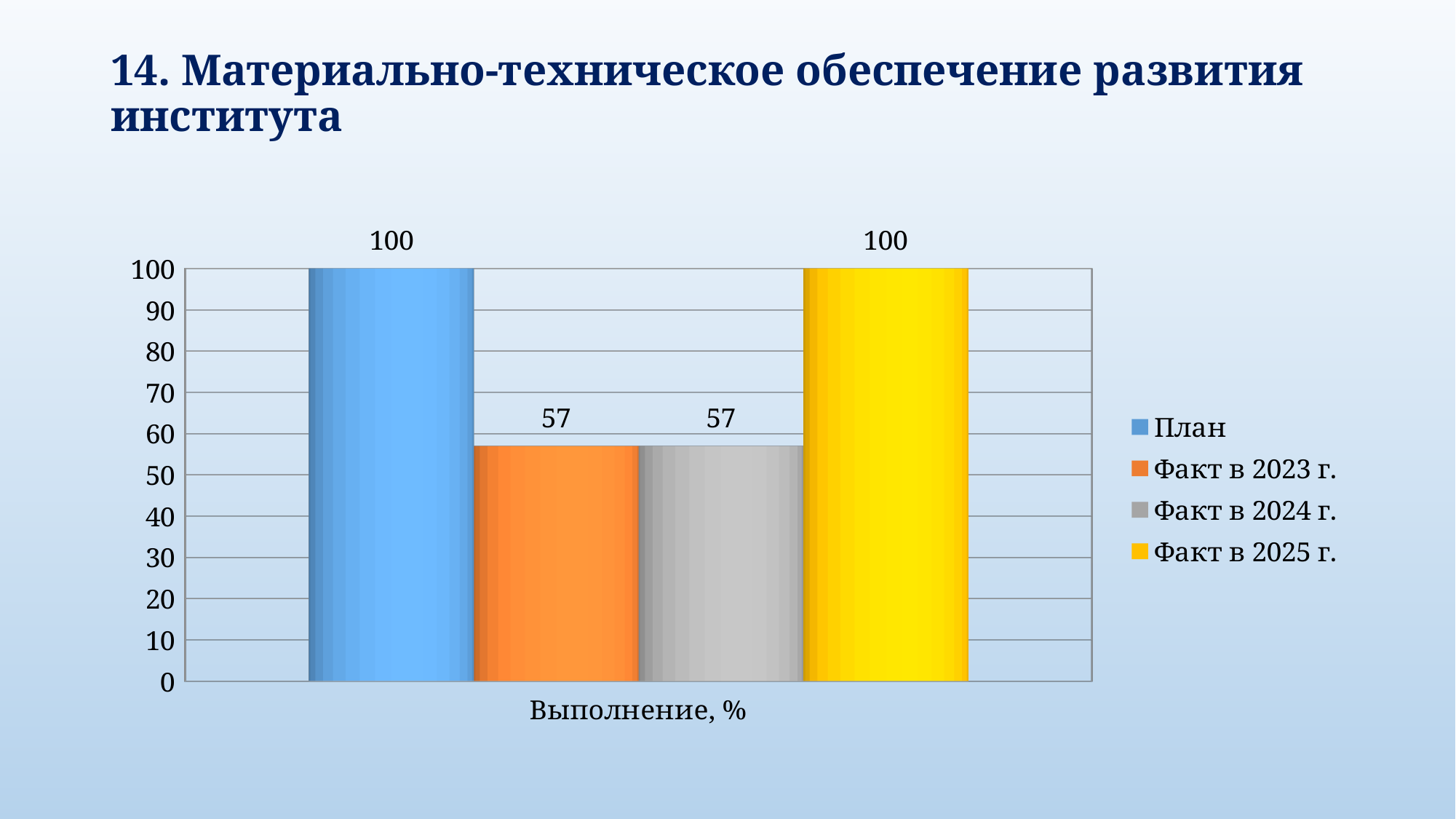
What is the value of the Факт в 2025 г. bar? 100 How many series does the legend list? 4 Which is larger, the Факт в 2024 г. value or the Факт в 2025 г. value? Факт в 2025 г. What is the value of the Факт в 2024 г. bar? 57 What colour is the Факт в 2025 г. bar? yellow What is the label on the x axis of the chart? Выполнение, % Is the value for Факт в 2024 г. greater or less than 60? less What is the value of the План bar? 100 Which series has the lowest value: План, Факт в 2023 г., or Факт в 2025 г.? Факт в 2023 г. What is the difference between the План value and the Факт в 2023 г. value? 43 What is the value of the Факт в 2023 г. bar? 57 What kind of chart is shown on the slide? bar chart